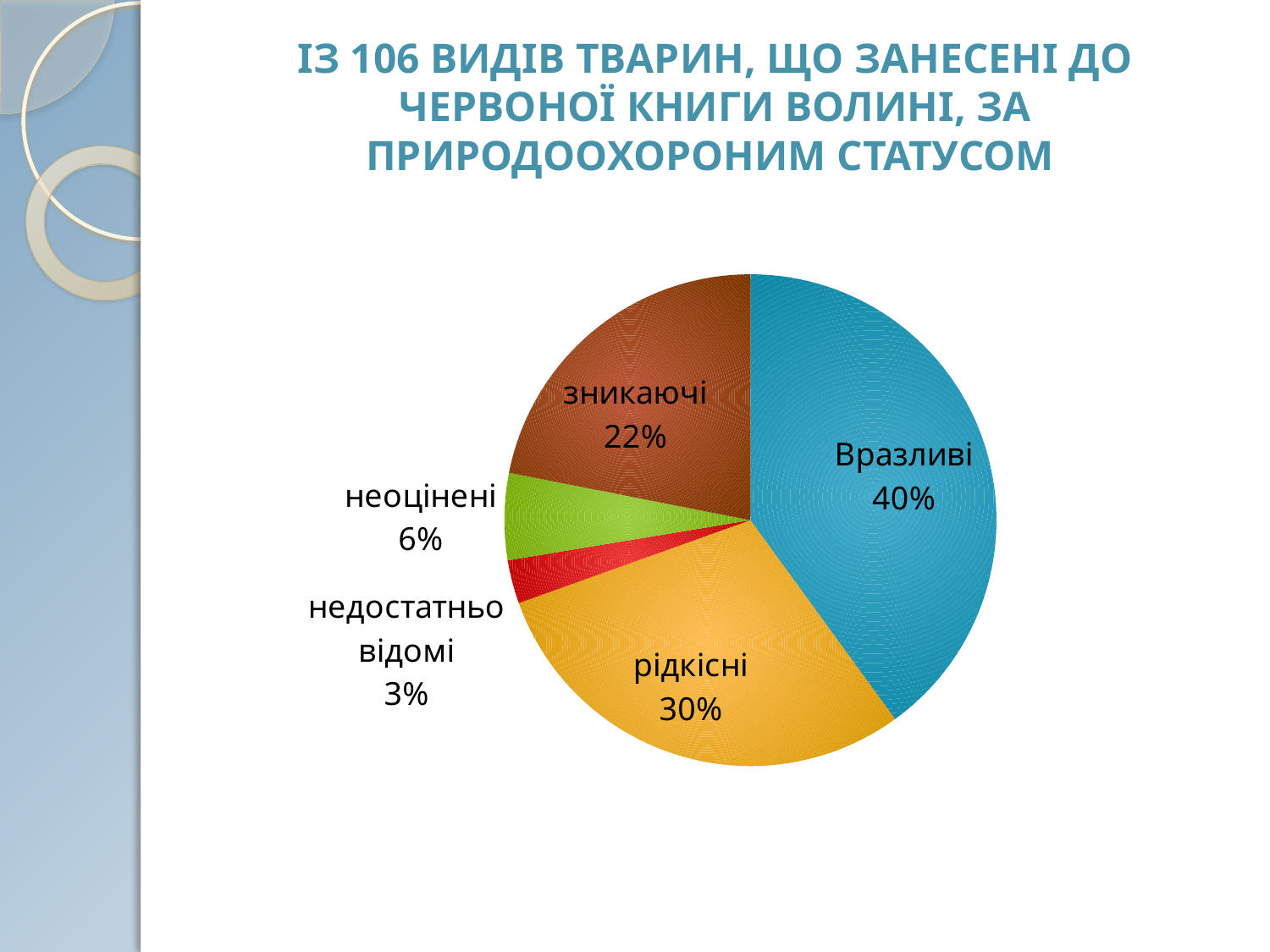
Which slice is larger, "зникаючі" or "неоцінені"? зникаючі How many slices does the pie chart have? 5 What share of the pie does the "неоцінені" slice represent? 6% Which category has the smallest slice of the pie? недостатньо відомі What kind of chart is shown on the slide? pie chart What is the difference in percentage points between the "Вразливі" and "рідкісні" slices? 10% What share of the pie does the "Вразливі" slice represent? 40% What share of the pie does the "рідкісні" slice represent? 30% Which category has the largest slice of the pie? Вразливі What colour is the "Вразливі" slice? blue